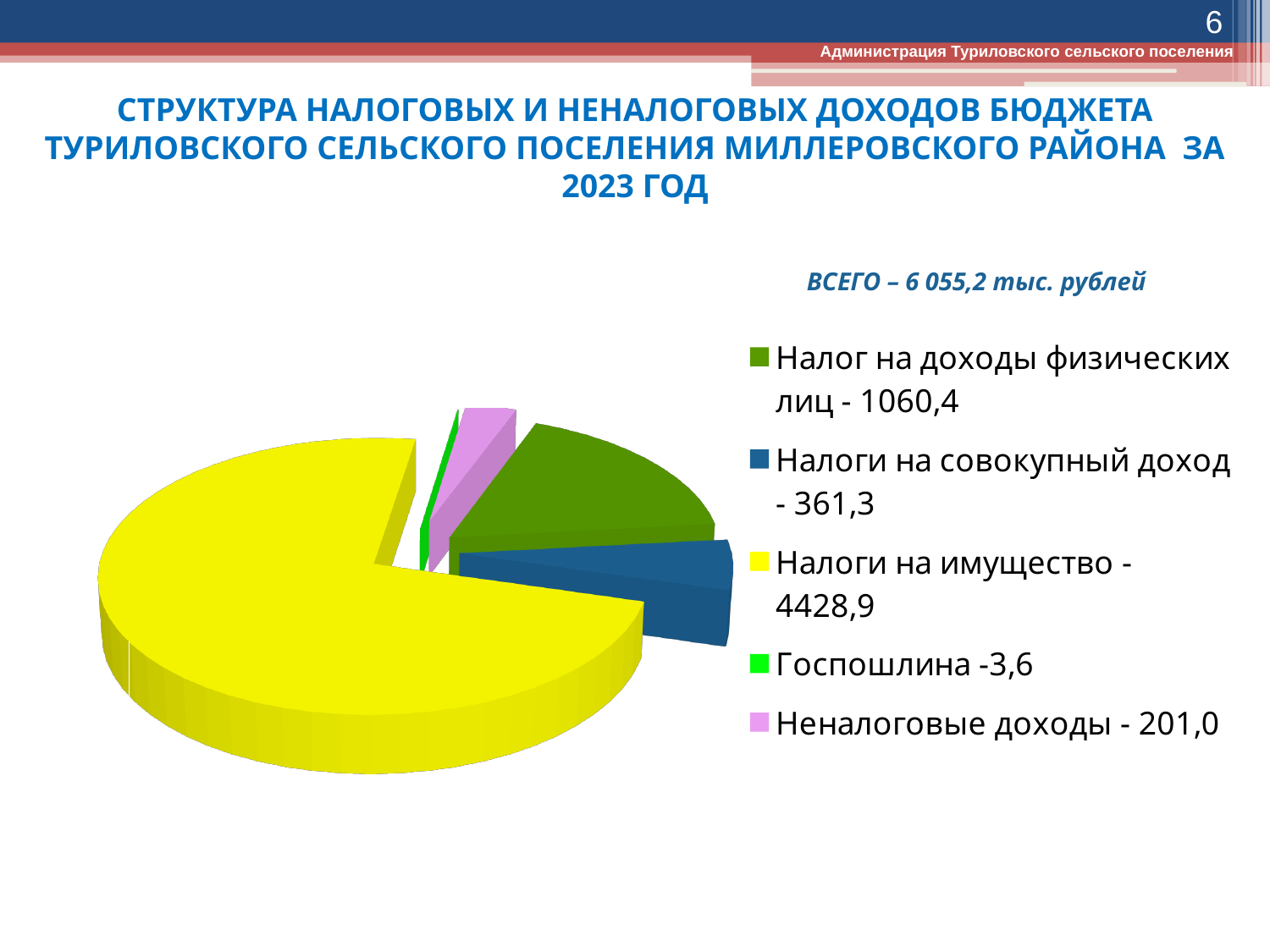
What is the value for Госпошлина? 3,6 What total amount (ВСЕГО) is stated on the slide? 6 055,2 тыс. рублей Which category has the largest share of the pie? Налоги на имущество What is the value for Неналоговые доходы? 201,0 How many categories does the pie chart show? 5 Which category has the smallest share of the pie? Госпошлина Which is larger: Налоги на совокупный доход or Неналоговые доходы? Налоги на совокупный доход What is the value for Налог на доходы физических лиц? 1060,4 What is the difference between Налоги на имущество and Налог на доходы физических лиц? 3368,5 What type of chart is shown on the slide? Pie chart What is the value for Налоги на имущество? 4428,9 What colour is the slice for Налоги на имущество? Yellow